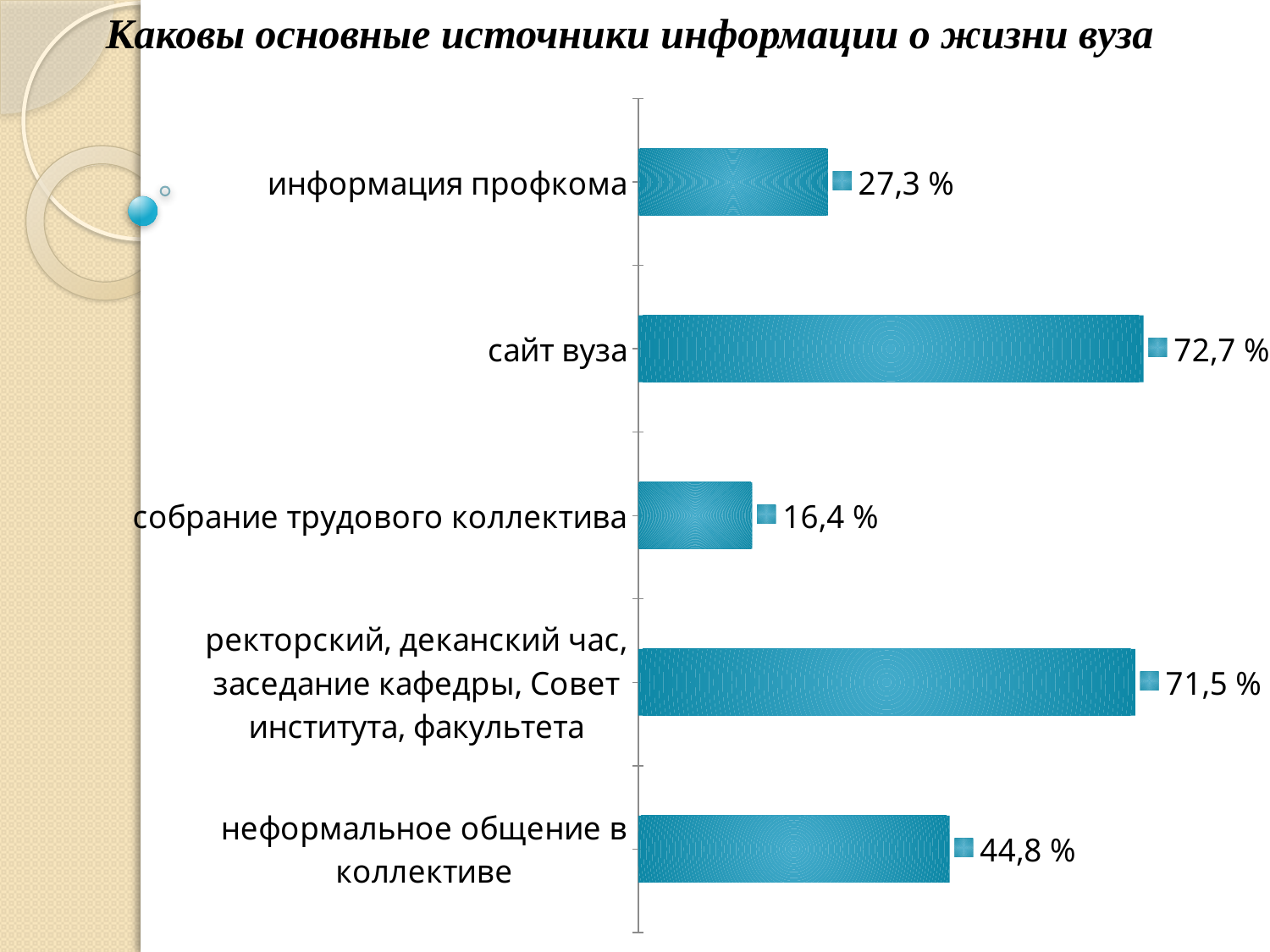
What is the difference between the values for «сайт вуза» and «ректорский, деканский час, заседание кафедры, Совет института, факультета»? 1,2 % What is the value for «сайт вуза»? 72,7 % What is the difference between the values for «неформальное общение в коллективе» and «информация профкома»? 17,5 % What is the value for «ректорский, деканский час, заседание кафедры, Совет института, факультета»? 71,5 % How many categories are shown in the chart? 5 What is the value for «неформальное общение в коллективе»? 44,8 % Which category has the highest value? сайт вуза What kind of chart is shown on the slide? bar chart Which is larger: the value for «неформальное общение в коллективе» or for «информация профкома»? неформальное общение в коллективе Which category has the lowest value? собрание трудового коллектива What is the value for «информация профкома»? 27,3 % What is the value for «собрание трудового коллектива»? 16,4 %